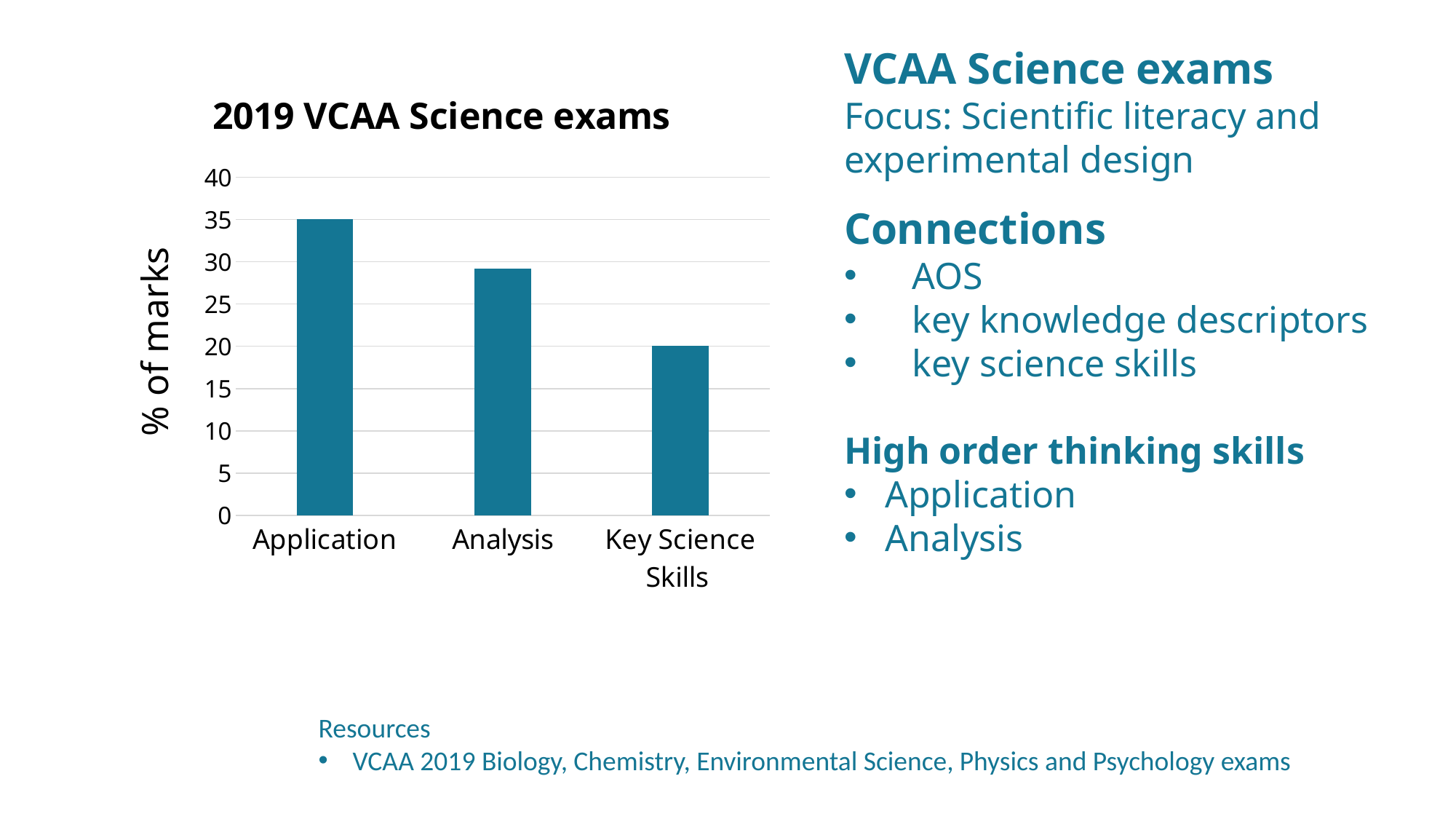
How many categories are plotted in the chart? 3 Which category has the lowest % of marks? Key Science Skills What is the title of the chart? 2019 VCAA Science exams What is the difference in % of marks between Application and Key Science Skills? 15 What is the % of marks for Application? 35 Is the value for Analysis greater or less than 25? greater What kind of chart is shown on the slide? bar chart Which has a higher % of marks, Analysis or Key Science Skills? Analysis Do the values rise or fall from left to right across the categories? fall Which category has the highest % of marks? Application Is the value for Analysis greater or less than 30? less What is the % of marks for Key Science Skills? 20